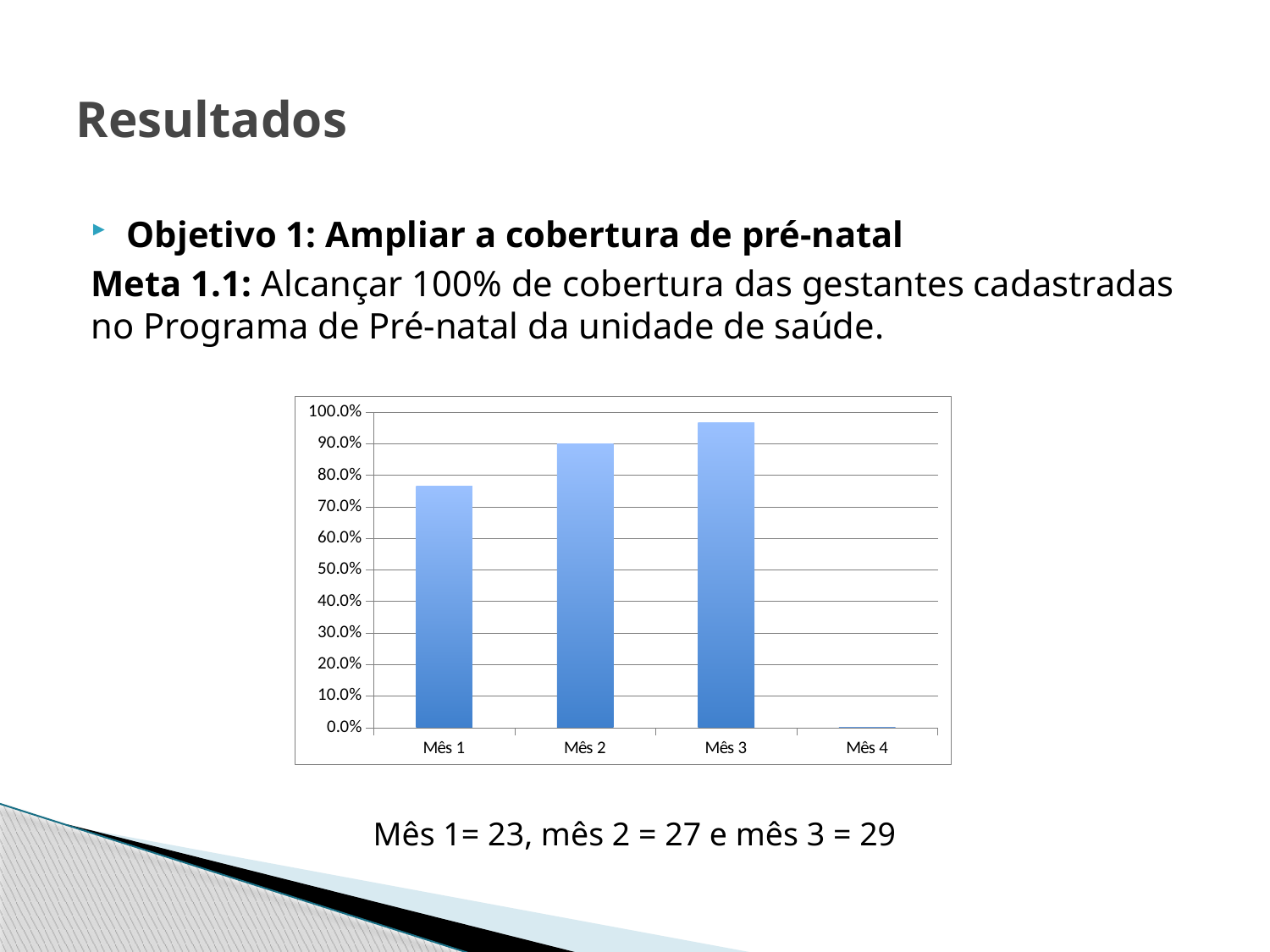
How many categories are shown on the x axis of the chart? 4 Is the value for Mês 1 greater or less than 80.0%? less Which is larger, the value for Mês 1 or the value for Mês 2? Mês 2 Is the value for Mês 3 greater or less than 90.0%? greater Is the value for Mês 2 greater or less than 80.0%? greater What is the highest value labelled on the y axis of the chart? 100.0% Which is larger, the value for Mês 2 or the value for Mês 3? Mês 3 Which month has the highest value in the chart? Mês 3 Do the values rise or fall from Mês 1 to Mês 3? rise Which month has the lowest value in the chart? Mês 4 What kind of chart is shown on the slide? bar chart